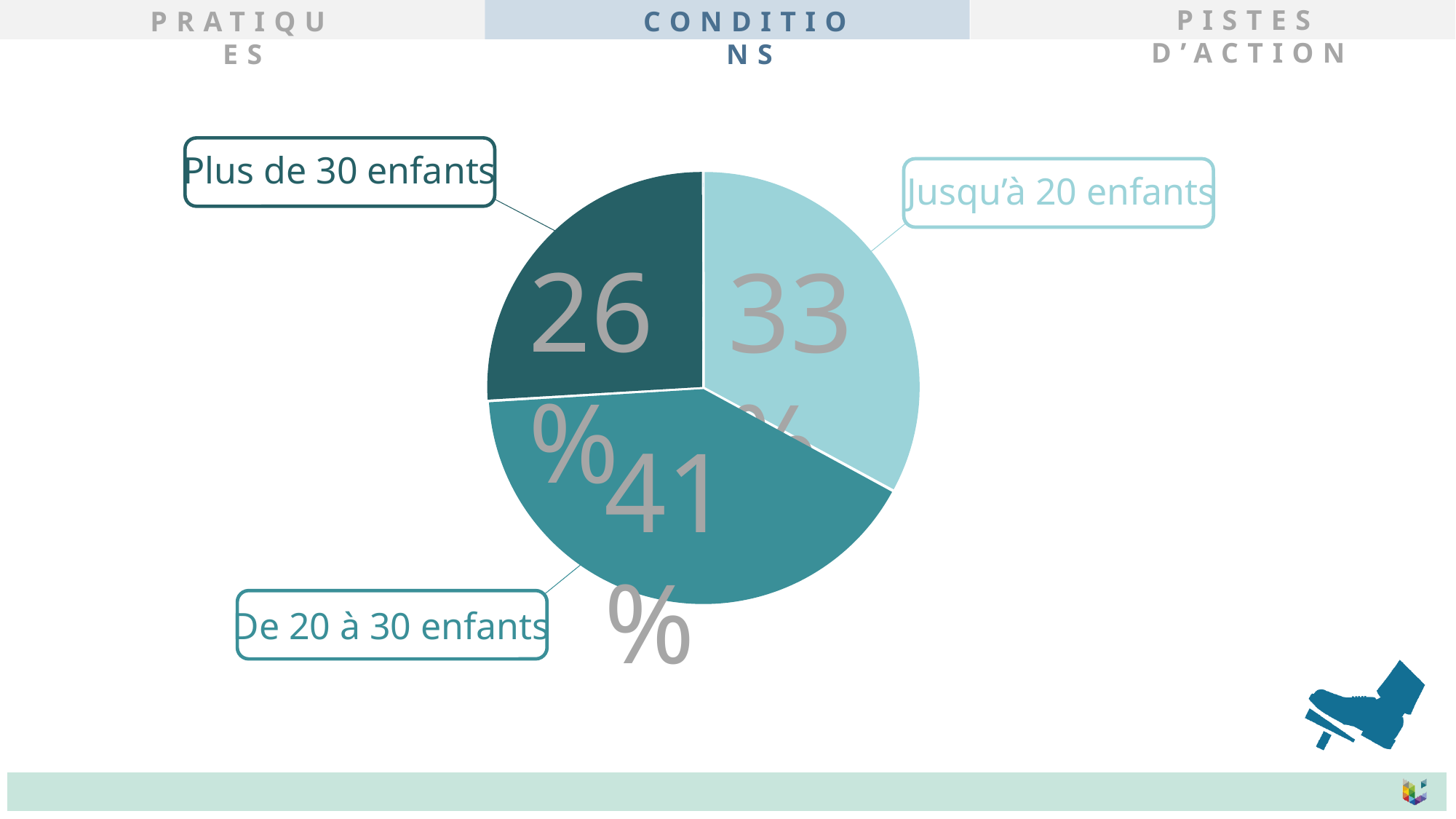
What share of the pie does the "De 20 à 30 enfants" slice represent? 41% What is the value shown for "De 20 à 30 enfants"? 41% Which is larger, the share for "Jusqu'à 20 enfants" or the share for "Plus de 30 enfants"? Jusqu'à 20 enfants How many slices does the pie chart have? 3 Which slice of the pie is drawn in the darkest colour? Plus de 30 enfants What kind of chart is shown on the slide? pie chart What is the value shown for "Jusqu'à 20 enfants"? 33% What is the value shown for "Plus de 30 enfants"? 26% What is the difference in percentage points between "Jusqu'à 20 enfants" and "Plus de 30 enfants"? 7 Which category has the smallest share of the pie? Plus de 30 enfants Which category has the largest share of the pie? De 20 à 30 enfants What is the difference in percentage points between "De 20 à 30 enfants" and "Plus de 30 enfants"? 15